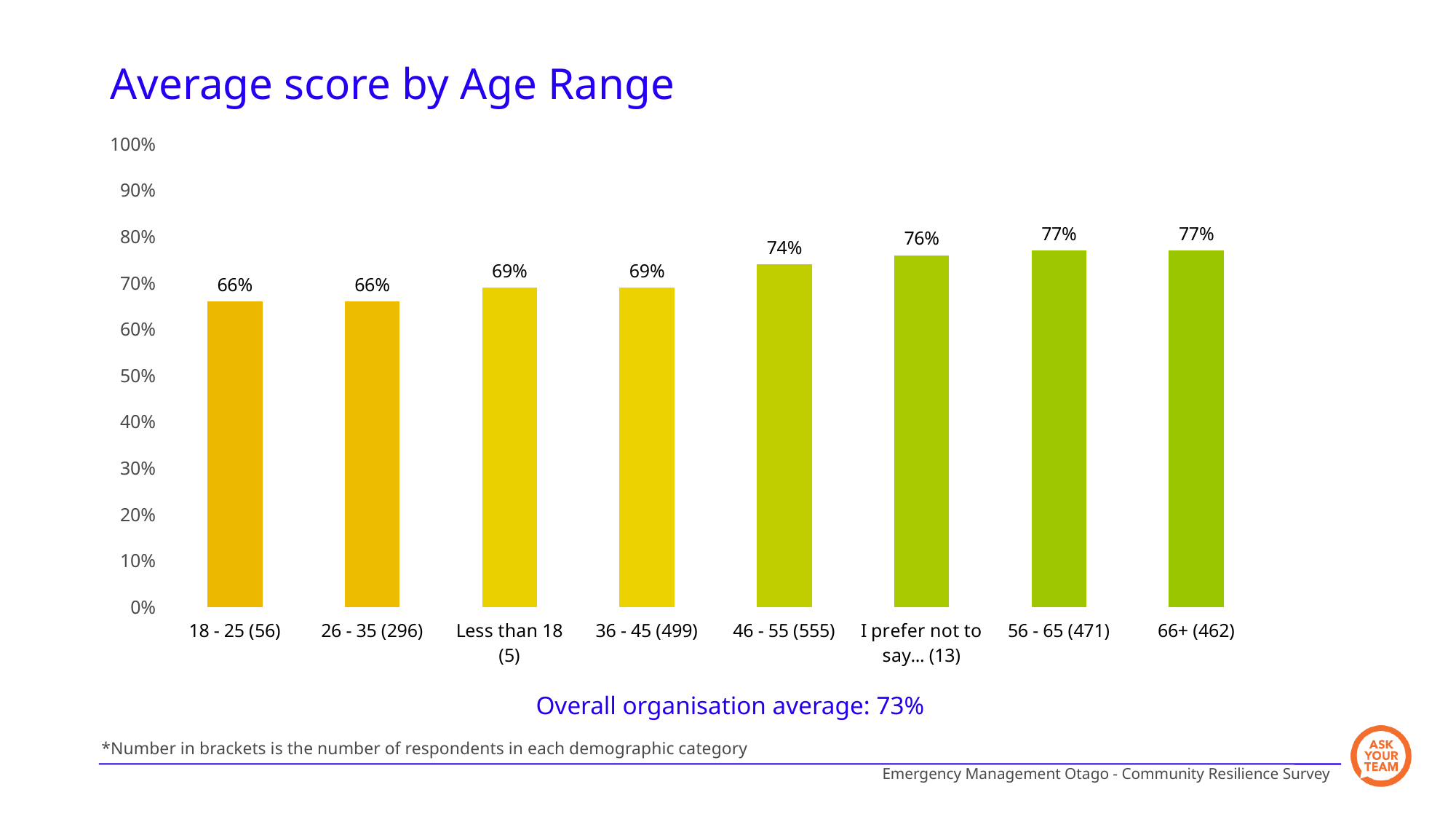
What is the average score for the 'I prefer not to say... (13)' category? 76% What is the average score for the 66+ (462) age range? 77% What is the average score for the 18 - 25 (56) age range? 66% Is the average score for 26 - 35 (296) greater or less than 70%? less What is the difference between the average score for 46 - 55 (555) and the average score for Less than 18 (5)? 5% What is the average score for the 36 - 45 (499) age range? 69% What is the difference between the average score for 56 - 65 (471) and the average score for 26 - 35 (296)? 11% What is the average score for the 46 - 55 (555) age range? 74% How many age range categories are shown in the chart? 8 What type of chart is shown on the slide? bar chart Which has a higher average score: 36 - 45 (499) or 46 - 55 (555)? 46 - 55 (555) What is the overall organisation average stated below the chart? 73%